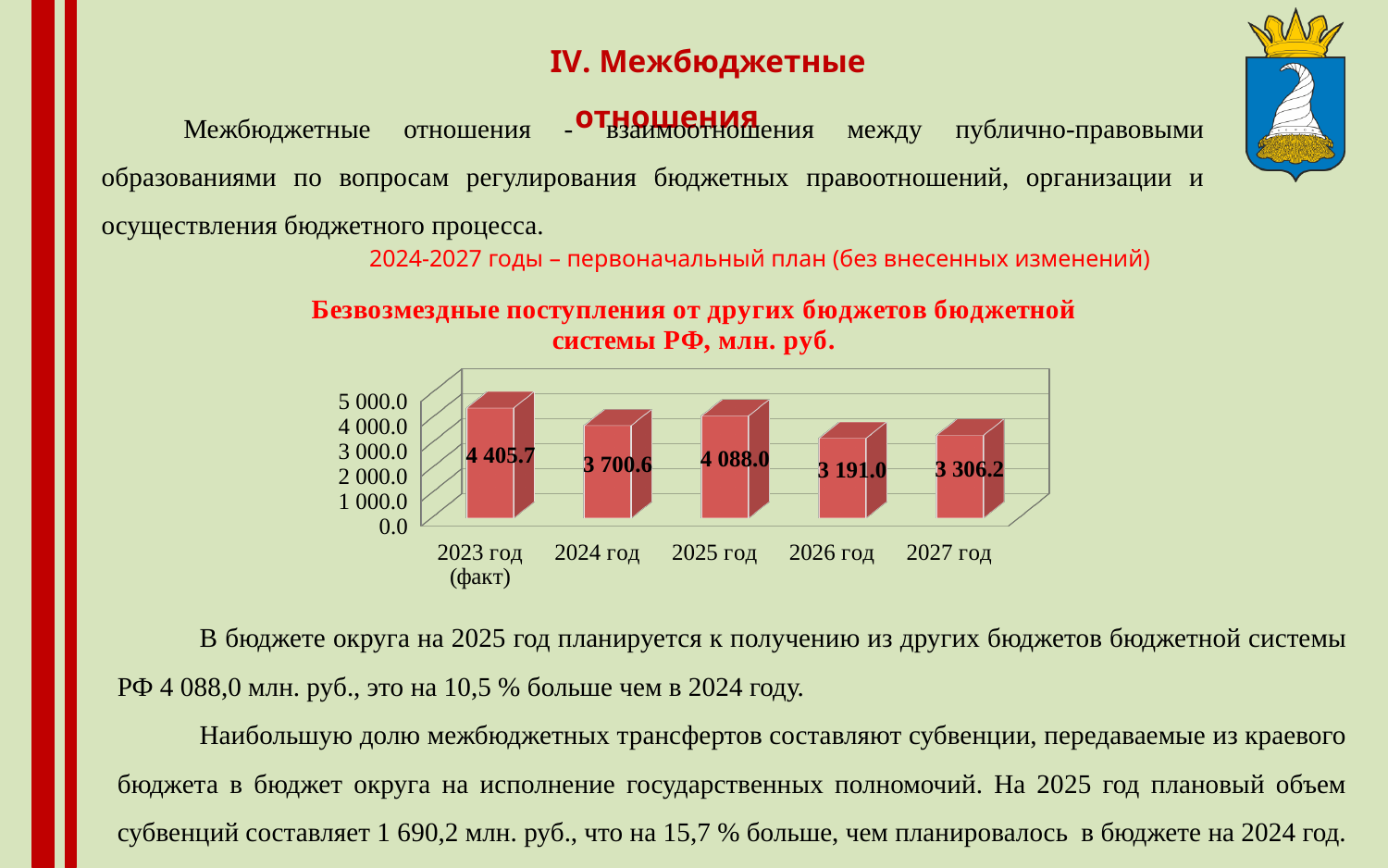
What is the value for 2025 год in the chart? 4 088.0 Which year has the highest value in the chart? 2023 год (факт) Which year has the lowest value in the chart? 2026 год What is the value for 2023 год (факт) in the chart? 4 405.7 What is the value for 2027 год in the chart? 3 306.2 What kind of chart is shown on the slide? bar chart Which is larger, the value for 2026 год or the value for 2027 год? 2027 год How many years are shown in the chart? 5 What is the difference between the values for 2025 год and 2024 год? 387.4 What is the title of the chart? Безвозмездные поступления от других бюджетов бюджетной системы РФ, млн. руб. What is the difference between the values for 2023 год (факт) and 2024 год? 705.1 Is the value for 2024 год greater or less than 4 000.0? less